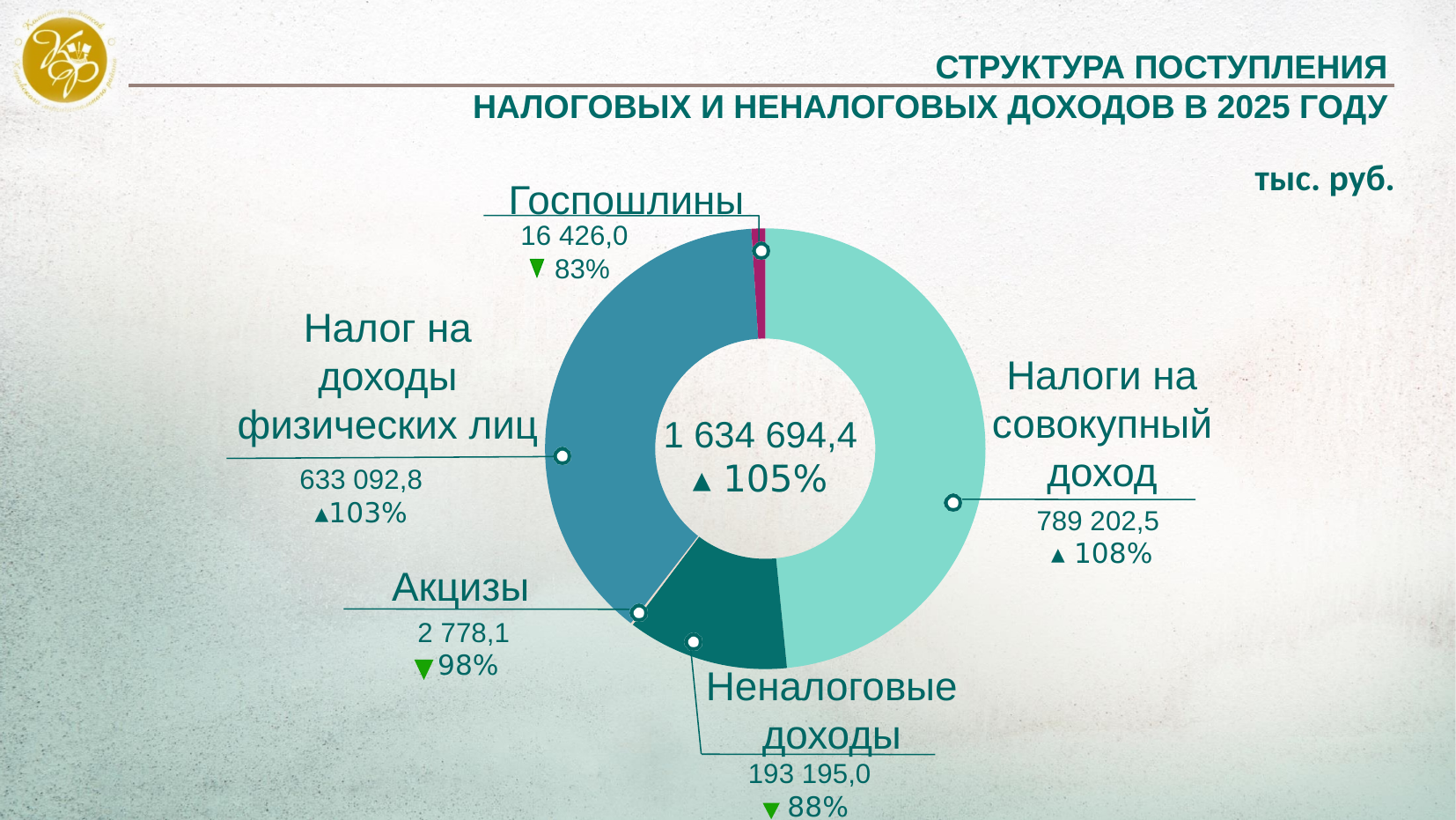
What total value is shown in the centre of the chart? 1 634 694,4 Which is larger, Неналоговые доходы or Госпошлины? Неналоговые доходы What percentage is shown next to Госпошлины? 83% What is the value for Налог на доходы физических лиц? 633 092,8 How many categories are shown in the chart? 5 What is the difference between Налоги на совокупный доход and Налог на доходы физических лиц? 156 109,7 Which category has the lowest value? Акцизы What is the value for Акцизы? 2 778,1 Which category has the highest value? Налоги на совокупный доход What is the value for Налоги на совокупный доход? 789 202,5 What is the value for Неналоговые доходы? 193 195,0 What kind of chart is shown on the slide? Pie (donut) chart